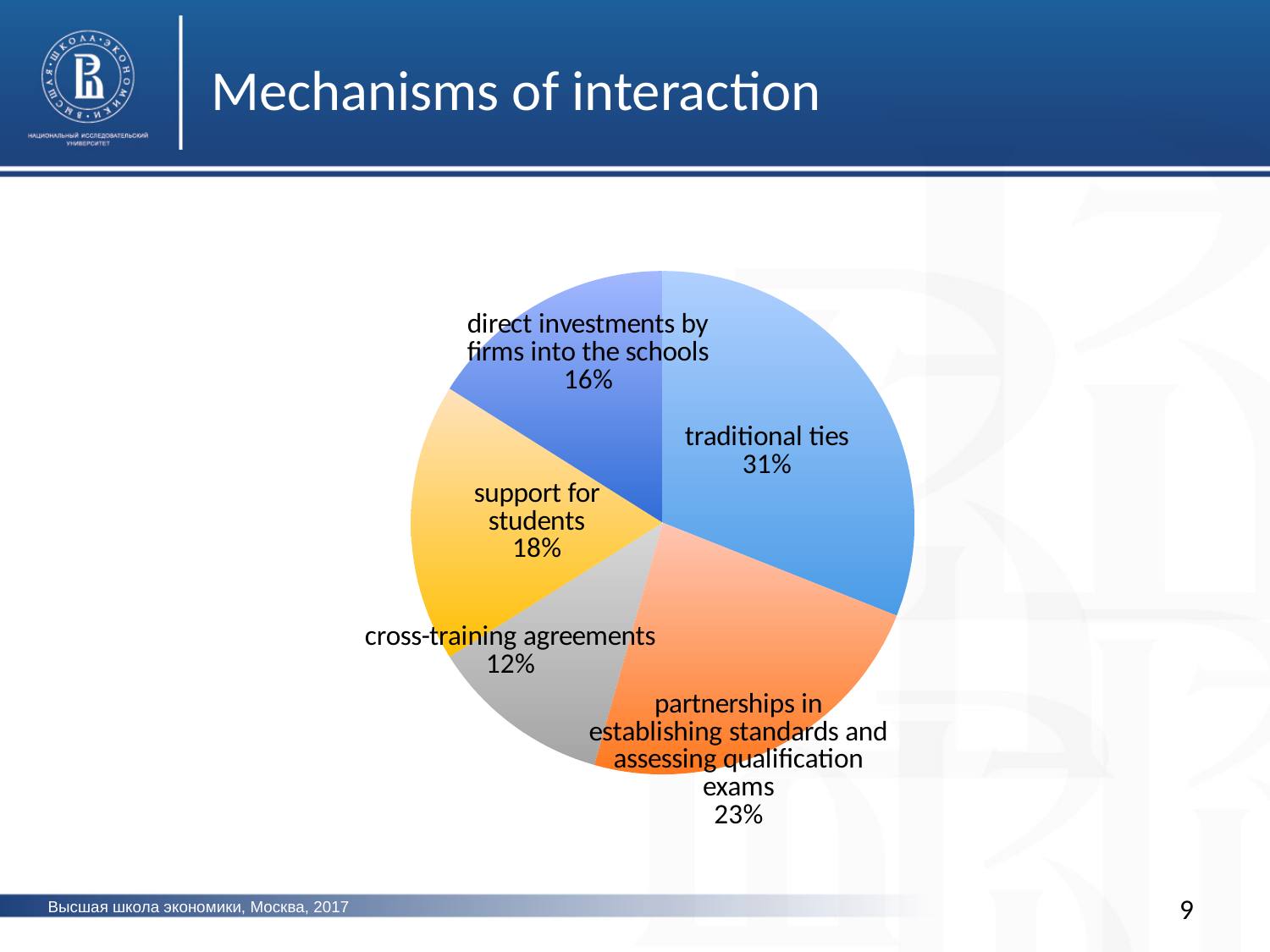
What is the value for "cross-training agreements"? 12% What is the value for "support for students"? 18% What is the difference in percentage points between "traditional ties" and "cross-training agreements"? 19 What is the title of the slide containing the pie chart? Mechanisms of interaction How many slices does the pie chart have? 5 What is the value for "direct investments by firms into the schools"? 16% What is the value for "partnerships in establishing standards and assessing qualification exams"? 23% What kind of chart is shown on the slide? pie chart Which is larger, "support for students" or "direct investments by firms into the schools"? support for students Which mechanism has the smallest share of the pie? cross-training agreements Which mechanism has the largest share of the pie? traditional ties What share does "traditional ties" have in the pie chart? 31%